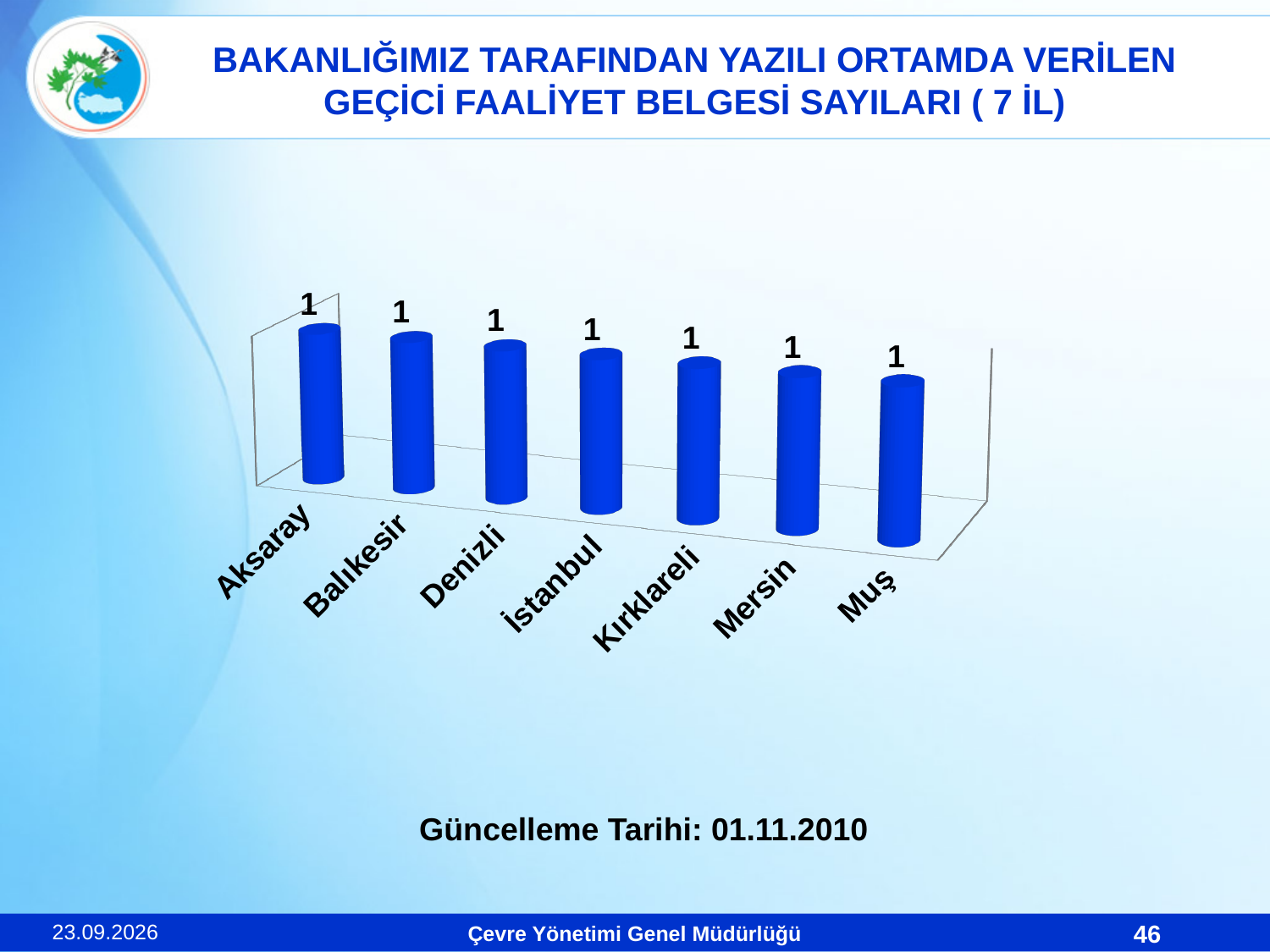
What is the value for Aksaray? 1 What is the value for Muş? 1 How many categories (provinces) are shown on the chart? 7 What is the value for Kırklareli? 1 What colour are the bars in the chart? Blue What kind of chart is shown on the slide? Bar chart What is the difference between the values for Balıkesir and Mersin? 0 What is the value for İstanbul? 1 Do the values rise, fall, or stay the same across the categories from Aksaray to Muş? Stay the same Which category is listed first on the x axis? Aksaray What is the value for Denizli? 1